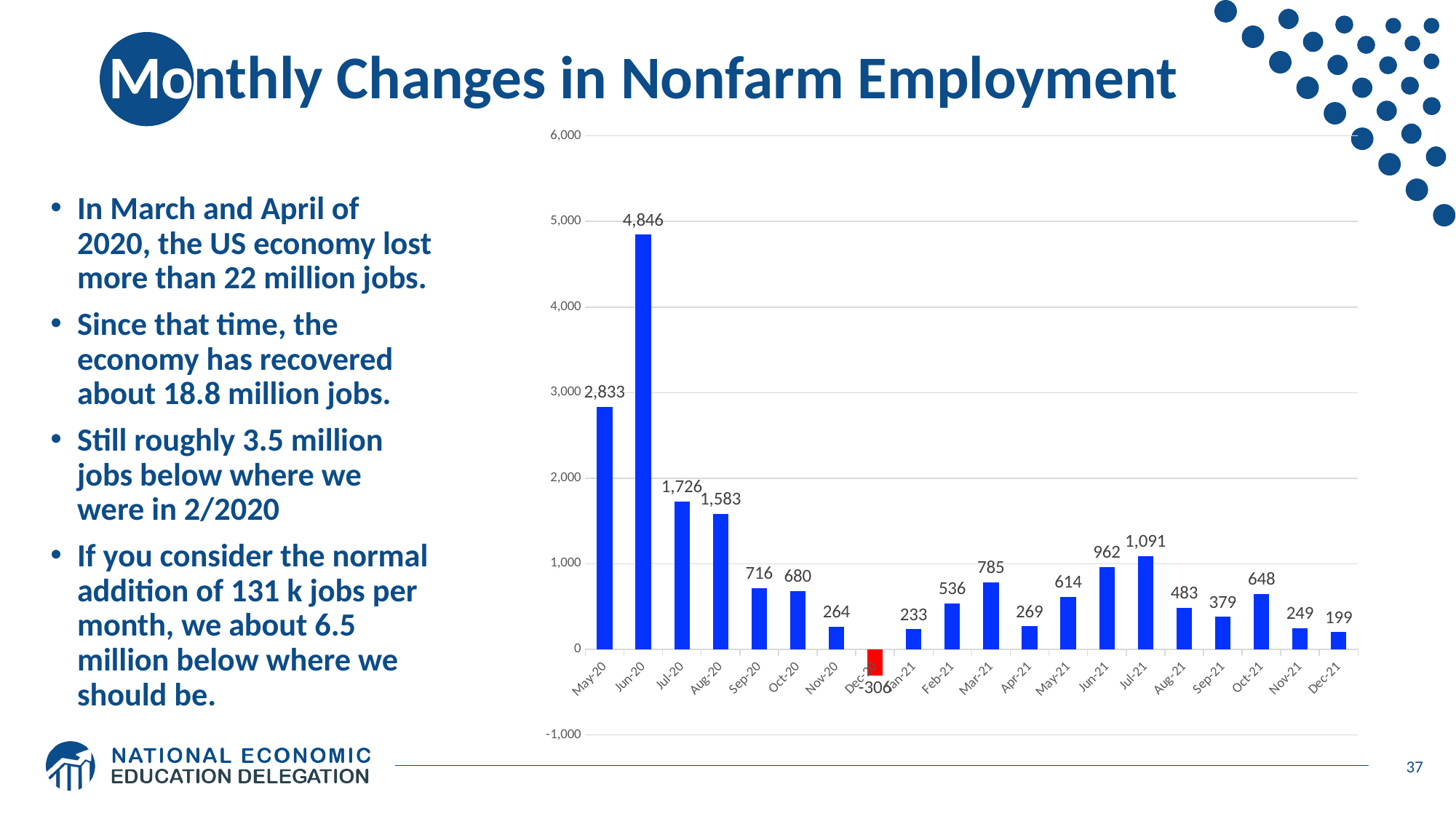
What is the difference between the values for Jul-20 and Aug-20? 143 How many months are plotted on the chart? 20 Which month has the lowest value? Dec-20 What is the difference between the values for Jul-21 and Jun-21? 129 What is the value for Jun-20? 4,846 What is the value for Mar-21? 785 Which month has the highest value? Jun-20 Is the value for May-20 greater or less than 2,000? greater Which is larger, the value for Oct-21 or the value for May-21? Oct-21 What kind of chart is shown on the slide? bar chart Which bar is coloured red instead of blue? Dec-20 What is the value for Dec-21? 199